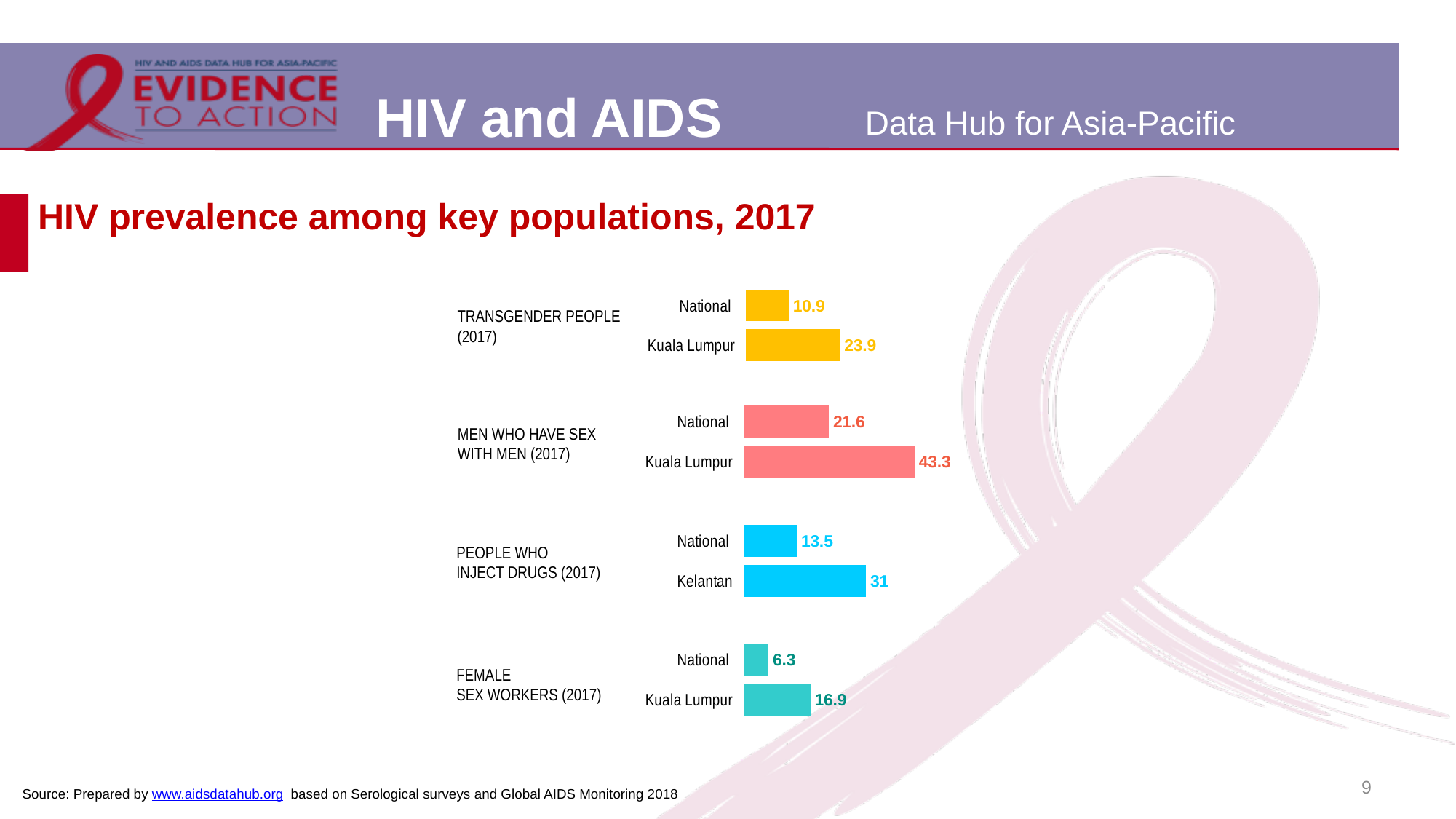
What is the Kelantan value for people who inject drugs (2017)? 31 Which bar has the highest value on the chart? Kuala Lumpur, men who have sex with men (43.3) What is the National HIV prevalence value for transgender people (2017)? 10.9 What is the difference between the Kelantan and National values for people who inject drugs? 17.5 Which is larger: the National value for men who have sex with men or the Kuala Lumpur value for transgender people? Kuala Lumpur value for transgender people (23.9) Which bar has the lowest value on the chart? National, female sex workers (6.3) What is the Kuala Lumpur value for men who have sex with men (2017)? 43.3 What is the difference between the Kuala Lumpur and National values for transgender people? 13 What is the National value for female sex workers (2017)? 6.3 What kind of chart is shown on the slide? Bar chart How many bars are plotted on the chart? 8 What is the title of the slide's chart section? HIV prevalence among key populations, 2017